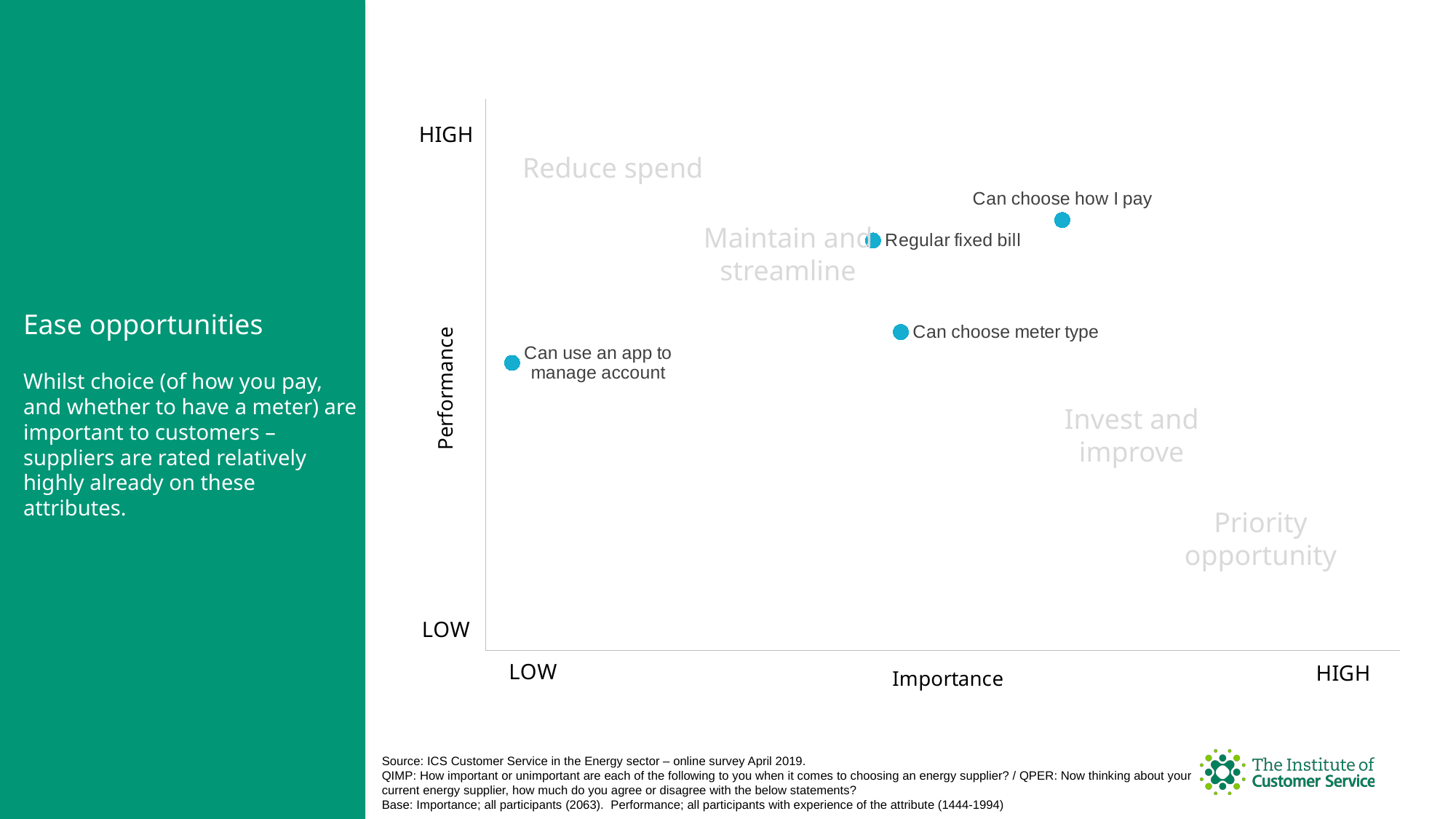
Which has higher performance: 'Regular fixed bill' or 'Can choose meter type'? Regular fixed bill Which attribute is plotted with the highest performance? Can choose how I pay What is the label of the vertical axis of the chart? Performance How many data points are plotted on the chart? 4 Which has higher importance: 'Regular fixed bill' or 'Can choose how I pay'? Can choose how I pay What kind of chart is shown on the slide? Scatter chart What is the label of the horizontal axis of the chart? Importance Which attribute is plotted with the lowest performance? Can use an app to manage account Which attribute is plotted with the highest importance? Can choose how I pay Which has higher importance: 'Can choose meter type' or 'Can use an app to manage account'? Can choose meter type Which attribute is plotted with the lowest importance? Can use an app to manage account